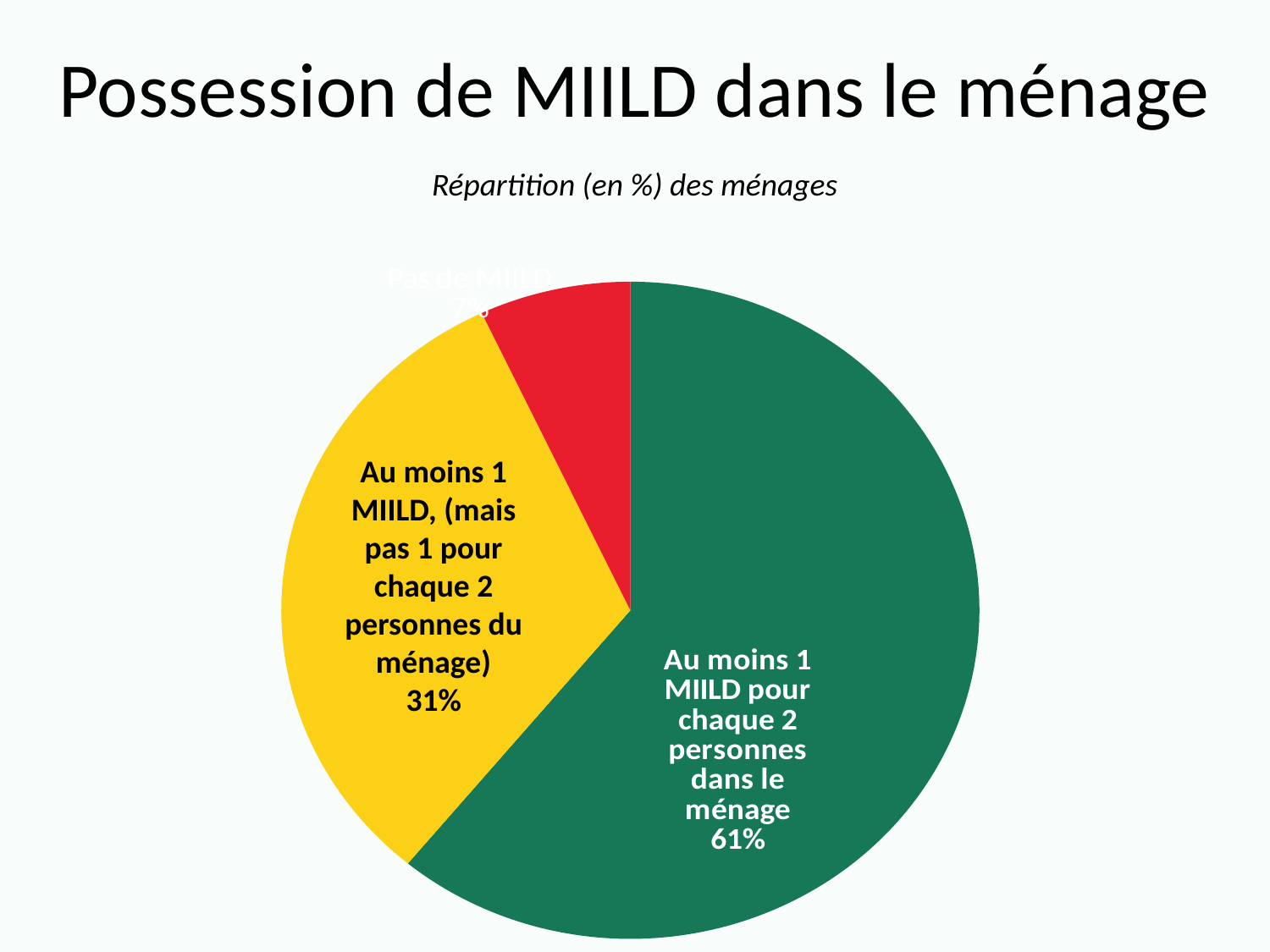
What kind of chart is shown on the slide? pie chart Which is larger: the share of households with at least 1 MIILD for every 2 people, or the share with at least 1 MIILD but not 1 for every 2 people? Au moins 1 MIILD pour chaque 2 personnes dans le ménage What is the difference in percentage points between the "Au moins 1 MIILD pour chaque 2 personnes dans le ménage" slice and the "Au moins 1 MIILD, (mais pas 1 pour chaque 2 personnes du ménage)" slice? 30 What colour is the slice for "Au moins 1 MIILD pour chaque 2 personnes dans le ménage"? green How many slices does the pie chart have? 3 Is the share for "Au moins 1 MIILD pour chaque 2 personnes dans le ménage" greater or less than 50%? greater What share of households have at least 1 MIILD for every 2 people in the household ("Au moins 1 MIILD pour chaque 2 personnes dans le ménage")? 61% What is the title of the slide containing the pie chart? Possession de MIILD dans le ménage What share of households have at least 1 MIILD but not 1 for every 2 people ("Au moins 1 MIILD, (mais pas 1 pour chaque 2 personnes du ménage)")? 31% Which category has the largest share of the pie? Au moins 1 MIILD pour chaque 2 personnes dans le ménage Which category has the smallest share of the pie? Pas de MIILD